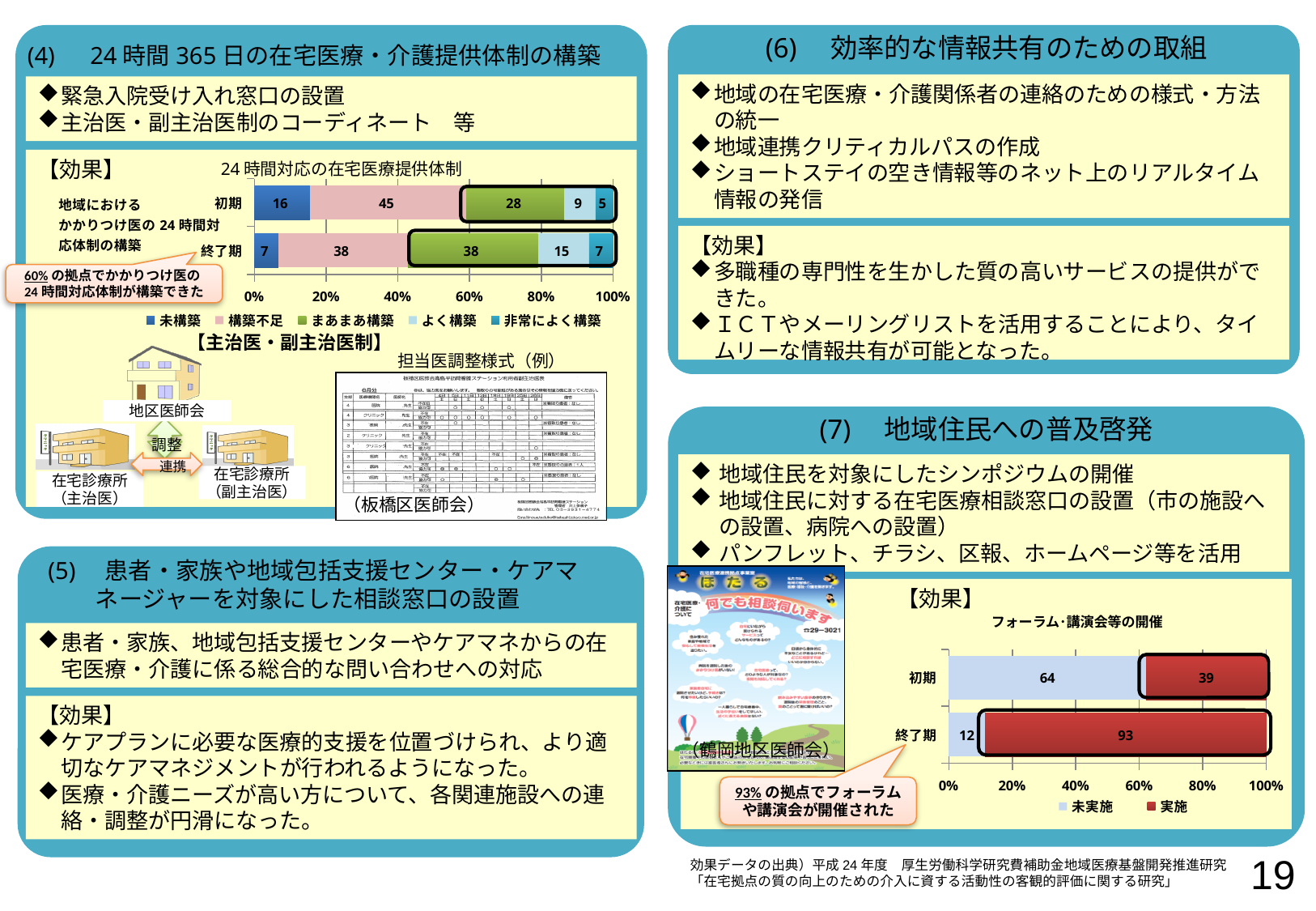
In the chart titled フォーラム・講演会等の開催, what is the difference between the 実施 values for 終了期 and 初期? 54 In the chart titled 24時間対応の在宅医療提供体制, which is larger: よく構築 for 初期 or よく構築 for 終了期? 終了期 In the chart titled フォーラム・講演会等の開催, what is the value for 未実施 in the 初期 bar? 64 In the chart titled 24時間対応の在宅医療提供体制, what is the value for 未構築 in the 初期 bar? 16 In the chart titled フォーラム・講演会等の開催, how many categories are shown on the vertical axis? 2 In the chart titled 24時間対応の在宅医療提供体制, how many series does the legend list? 5 In the chart titled フォーラム・講演会等の開催, what is the value for 実施 in the 終了期 bar? 93 In the chart titled 24時間対応の在宅医療提供体制, what is the difference between the 未構築 values for 初期 and 終了期? 9 In the chart titled 24時間対応の在宅医療提供体制, what is the value for 非常によく構築 in the 初期 bar? 5 In the chart titled 24時間対応の在宅医療提供体制, what is the value for まあまあ構築 in the 終了期 bar? 38 What kind of chart is the chart titled フォーラム・講演会等の開催? Stacked horizontal bar chart In the chart titled 24時間対応の在宅医療提供体制, which segment is largest in the 初期 bar? 構築不足